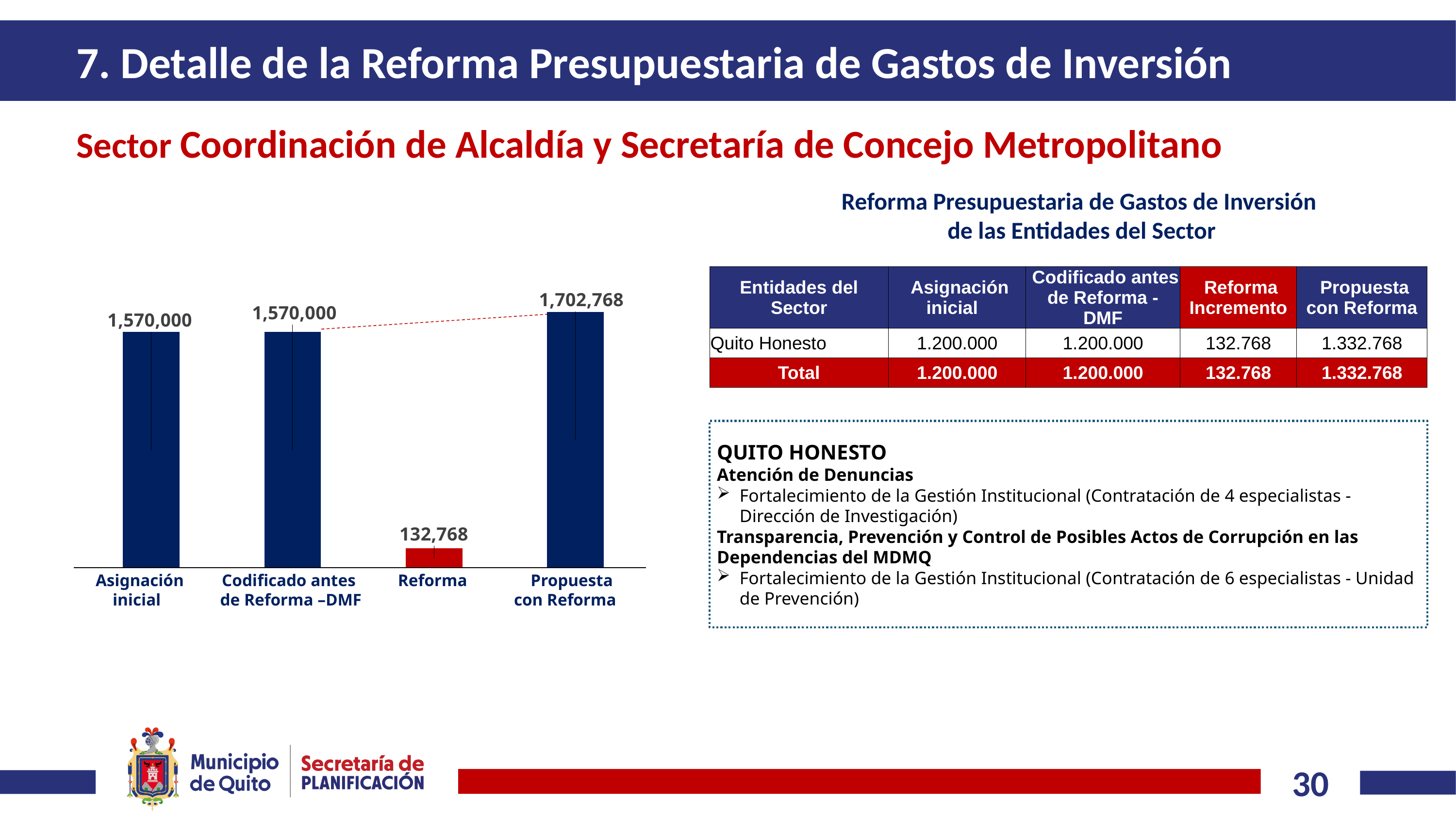
What is the value of the Asignación inicial bar in the chart? 1,570,000 Which is larger in the chart, the Reforma bar or the Asignación inicial bar? Asignación inicial Which category has the highest value in the chart? Propuesta con Reforma What is the value of the Reforma bar in the chart? 132,768 What type of chart is shown on the slide? Bar chart What is the value of the Propuesta con Reforma bar in the chart? 1,702,768 Which category has the lowest value in the chart? Reforma How many bars are shown in the chart? 4 What is the value of the Codificado antes de Reforma –DMF bar in the chart? 1,570,000 What colour is the Reforma bar in the chart? Red What is the difference between the Propuesta con Reforma bar and the Codificado antes de Reforma –DMF bar? 132,768 Do the Asignación inicial and Codificado antes de Reforma –DMF bars have the same value? Yes